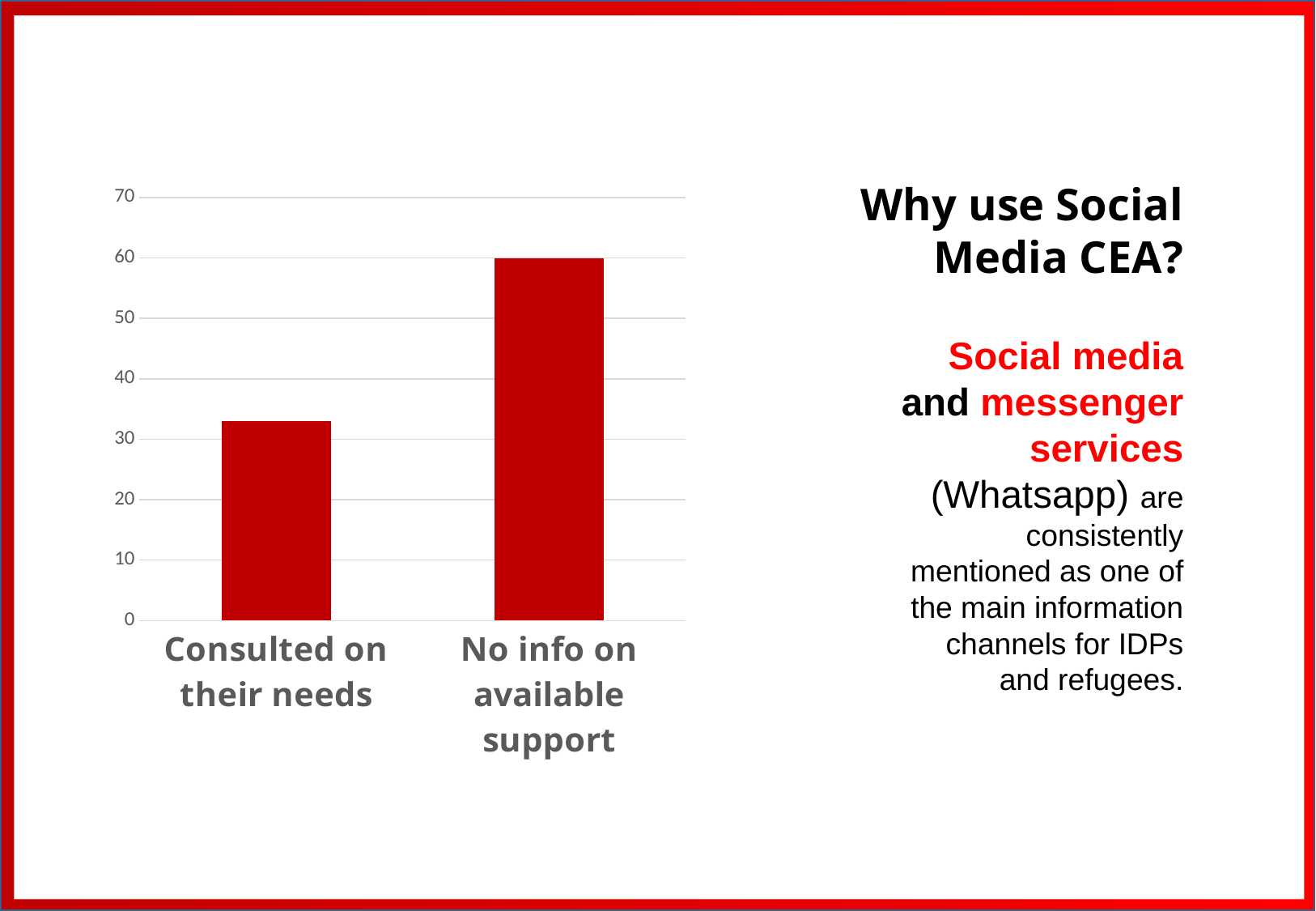
Which category has the highest value in the bar chart? No info on available support How many categories are shown in the bar chart? 2 Which is larger: the value for 'Consulted on their needs' or the value for 'No info on available support'? No info on available support What is the value for 'No info on available support'? 60 Is the value for 'No info on available support' greater or less than 50? greater Which category has the lowest value in the bar chart? Consulted on their needs Is the value for 'No info on available support' greater or less than 70? less What is the highest value shown on the vertical axis of the bar chart? 70 Is the value for 'Consulted on their needs' greater or less than 40? less What kind of chart is shown on the slide? bar chart What colour are the bars in the chart? red